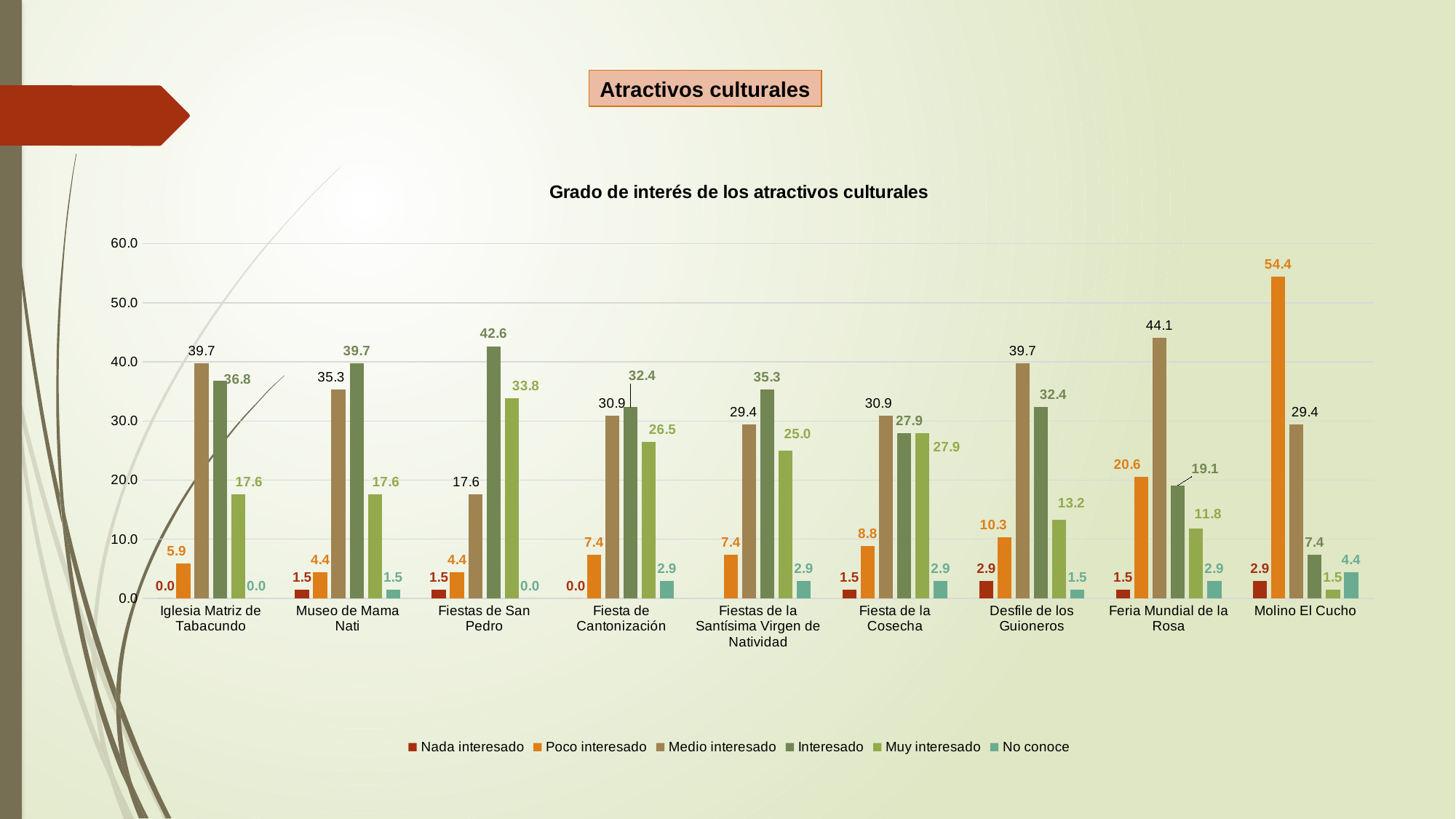
What kind of chart is shown on the slide? Bar chart How many categories are shown on the x axis? 9 Which category has the highest value for "Poco interesado"? Molino El Cucho What is the title of the chart? Grado de interés de los atractivos culturales What is the value for "Interesado" for Fiestas de San Pedro? 42.6 What is the value for "Muy interesado" for Fiesta de Cantonización? 26.5 Which is larger: the "Muy interesado" value for Fiestas de San Pedro or the "Muy interesado" value for Desfile de los Guioneros? Fiestas de San Pedro What is the difference between the "Interesado" value for Fiestas de San Pedro and the "Interesado" value for Feria Mundial de la Rosa? 23.5 What is the value for "Medio interesado" for Feria Mundial de la Rosa? 44.1 What is the value for "Poco interesado" for Molino El Cucho? 54.4 Which category has the lowest value for "Interesado"? Molino El Cucho How many series does the legend list? 6